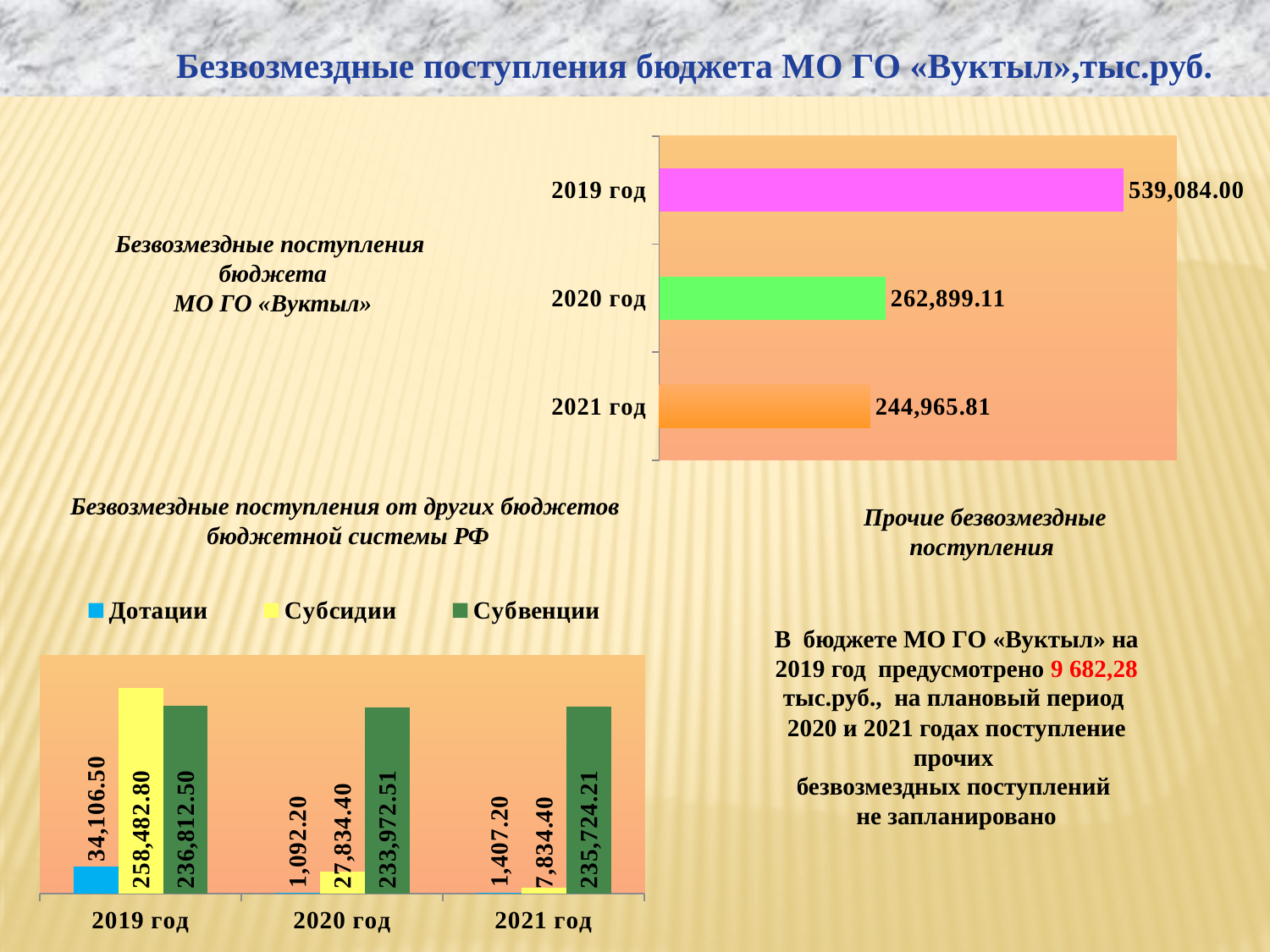
In the top-right chart 'Безвозмездные поступления бюджета МО ГО «Вуктыл»', do the values rise or fall from 2019 год to 2021 год? fall In the top-right chart 'Безвозмездные поступления бюджета МО ГО «Вуктыл»', what is the value for 2021 год? 244,965.81 In the bottom-left chart 'Безвозмездные поступления от других бюджетов бюджетной системы РФ', what is the value of Субсидии for 2019 год? 258,482.80 What kind of chart is the top-right chart 'Безвозмездные поступления бюджета МО ГО «Вуктыл»'? bar chart In the bottom-left chart 'Безвозмездные поступления от других бюджетов бюджетной системы РФ', what is the value of Дотации for 2021 год? 1,407.20 In the top-right chart 'Безвозмездные поступления бюджета МО ГО «Вуктыл»', which year has the highest value? 2019 год In the bottom-left chart 'Безвозмездные поступления от других бюджетов бюджетной системы РФ', which is larger for 2020 год: Субсидии or Субвенции? Субвенции In the bottom-left chart 'Безвозмездные поступления от других бюджетов бюджетной системы РФ', what is the difference between Субсидии in 2019 год and Субсидии in 2020 год? 230,648.40 In the bottom-left chart 'Безвозмездные поступления от других бюджетов бюджетной системы РФ', how many series does the legend list? 3 In the top-right chart 'Безвозмездные поступления бюджета МО ГО «Вуктыл»', what is the value for 2019 год? 539,084.00 In the bottom-left chart 'Безвозмездные поступления от других бюджетов бюджетной системы РФ', which year has the lowest value of Дотации? 2020 год In the top-right chart 'Безвозмездные поступления бюджета МО ГО «Вуктыл»', what is the difference between the 2019 год and 2020 год values? 276,184.89